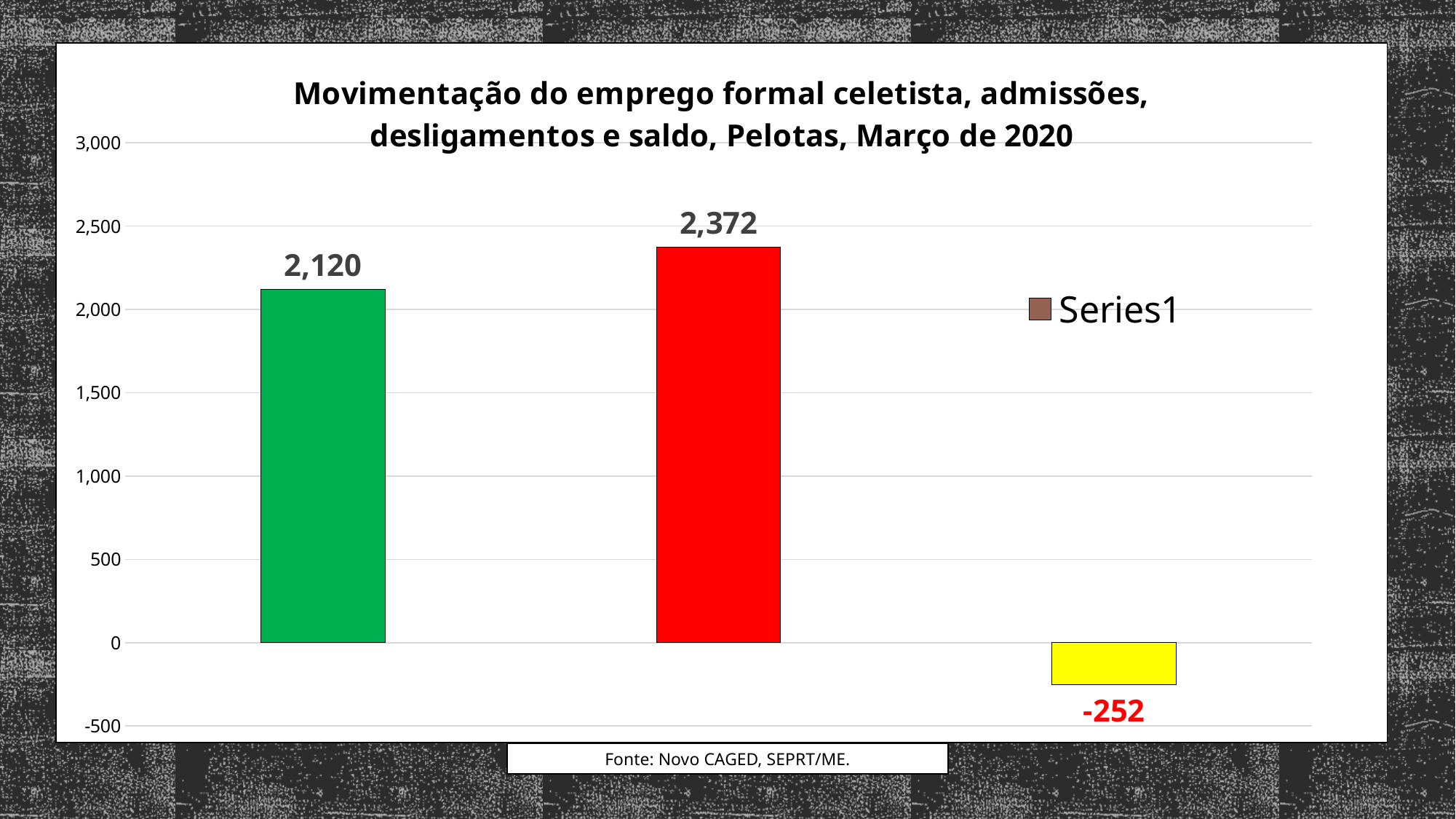
Which is larger, the value of the green bar or the value of the red bar? the red bar How many series does the legend list? 1 What is the value shown on the green bar (the first bar from the left)? 2,120 What kind of chart is shown on the slide? bar chart What is the name of the series shown in the legend? Series1 What is the value shown on the red bar (the middle bar)? 2,372 What is the difference between the value of the red bar and the value of the green bar? 252 What is the value shown on the yellow bar (the rightmost bar)? -252 Is the value of the green bar greater or less than 2,000? greater How many bars are plotted in the chart? 3 Which bar has the lowest value: the green, red or yellow bar? the yellow bar Which bar has the highest value: the green, red or yellow bar? the red bar